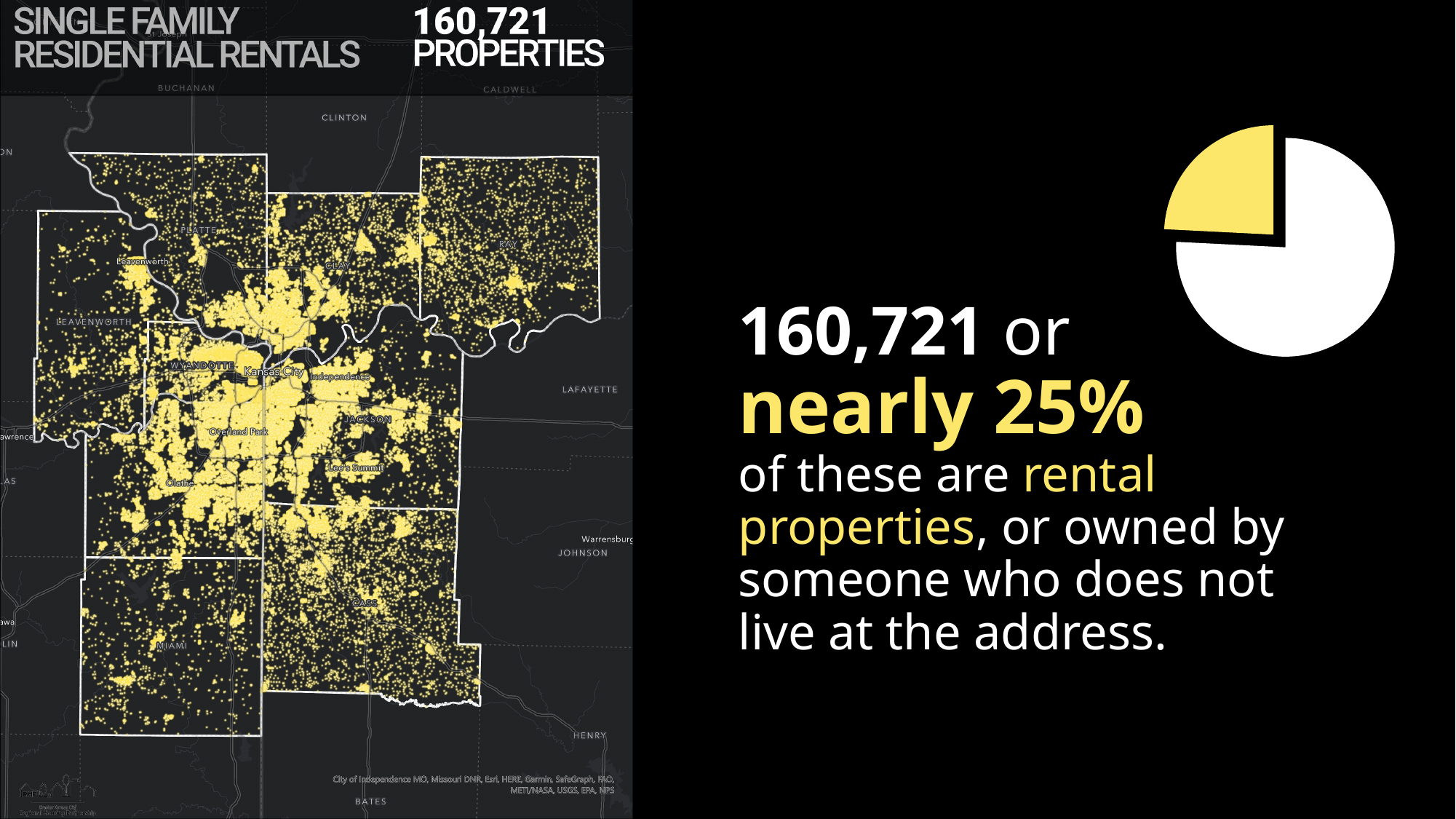
How many slices does the pie chart have? 2 What kind of chart is shown on the right side of the slide? pie chart Which slice of the pie chart is the smallest? the yellow slice What colour is the exploded (pulled-out) slice of the pie chart? yellow According to the slide, how many properties are rental properties? 160,721 According to the text next to the pie chart, what share of properties does the yellow slice represent? nearly 25% Which slice of the pie chart is larger, the yellow slice or the white slice? white What is the title of the map on the left side of the slide? Single Family Residential Rentals Is the yellow slice of the pie chart greater or less than half of the pie? less